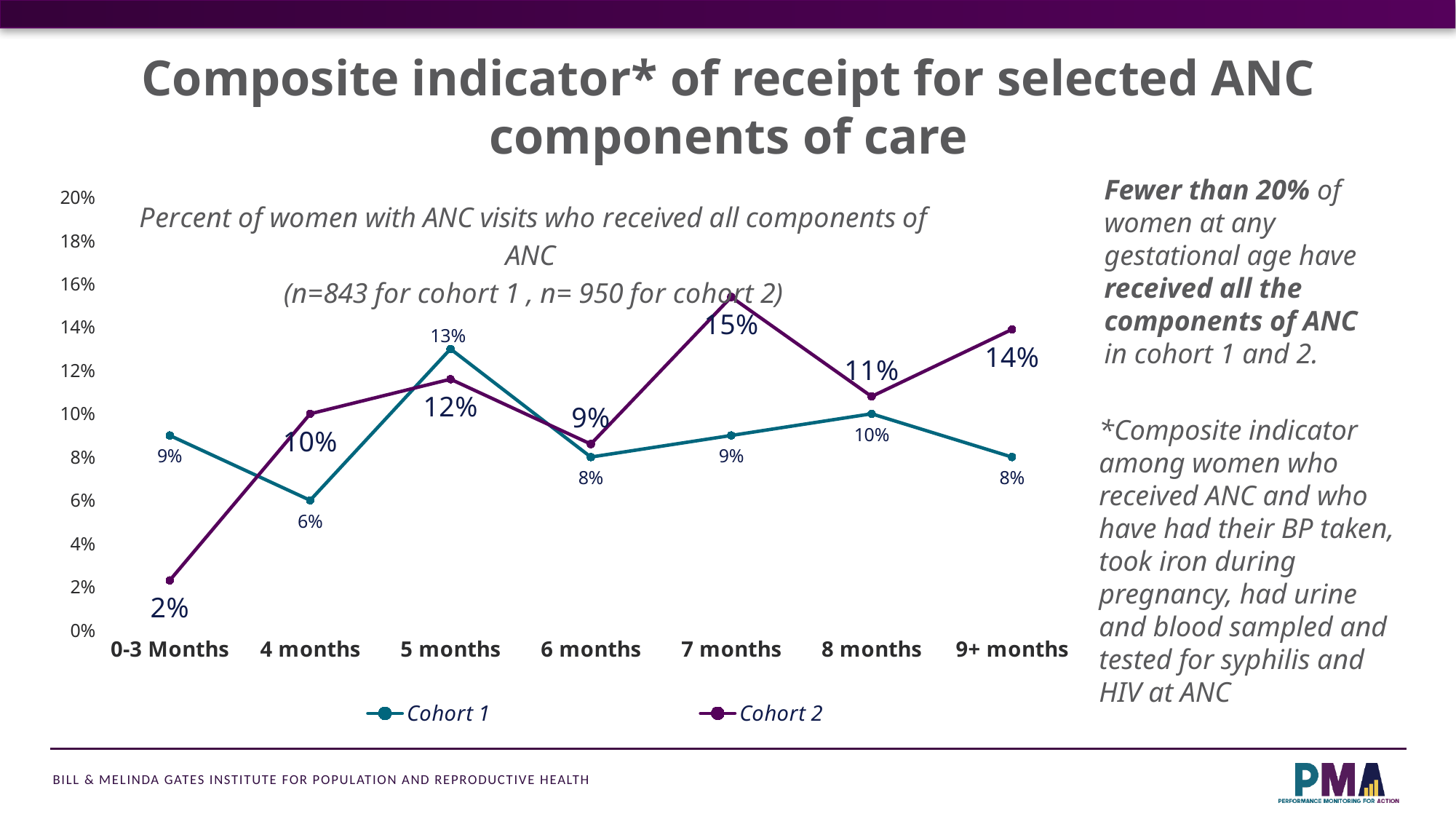
What is the value for Cohort 2 at 9+ months? 14% What is the value for Cohort 2 at 0-3 Months? 2% How many gestational age categories are shown on the x axis? 7 Is the value for Cohort 2 at 7 months greater or less than 14%? greater What is the value for Cohort 1 at 5 months? 13% How many series does the legend list? 2 Which cohort has the larger value at 4 months? Cohort 2 What kind of chart is shown on the slide? Line chart What is the difference between Cohort 2 and Cohort 1 at 7 months? 6% At which gestational age is Cohort 2 highest? 7 months Which colour is used for the Cohort 2 line? Purple At which gestational age is Cohort 1 lowest? 4 months